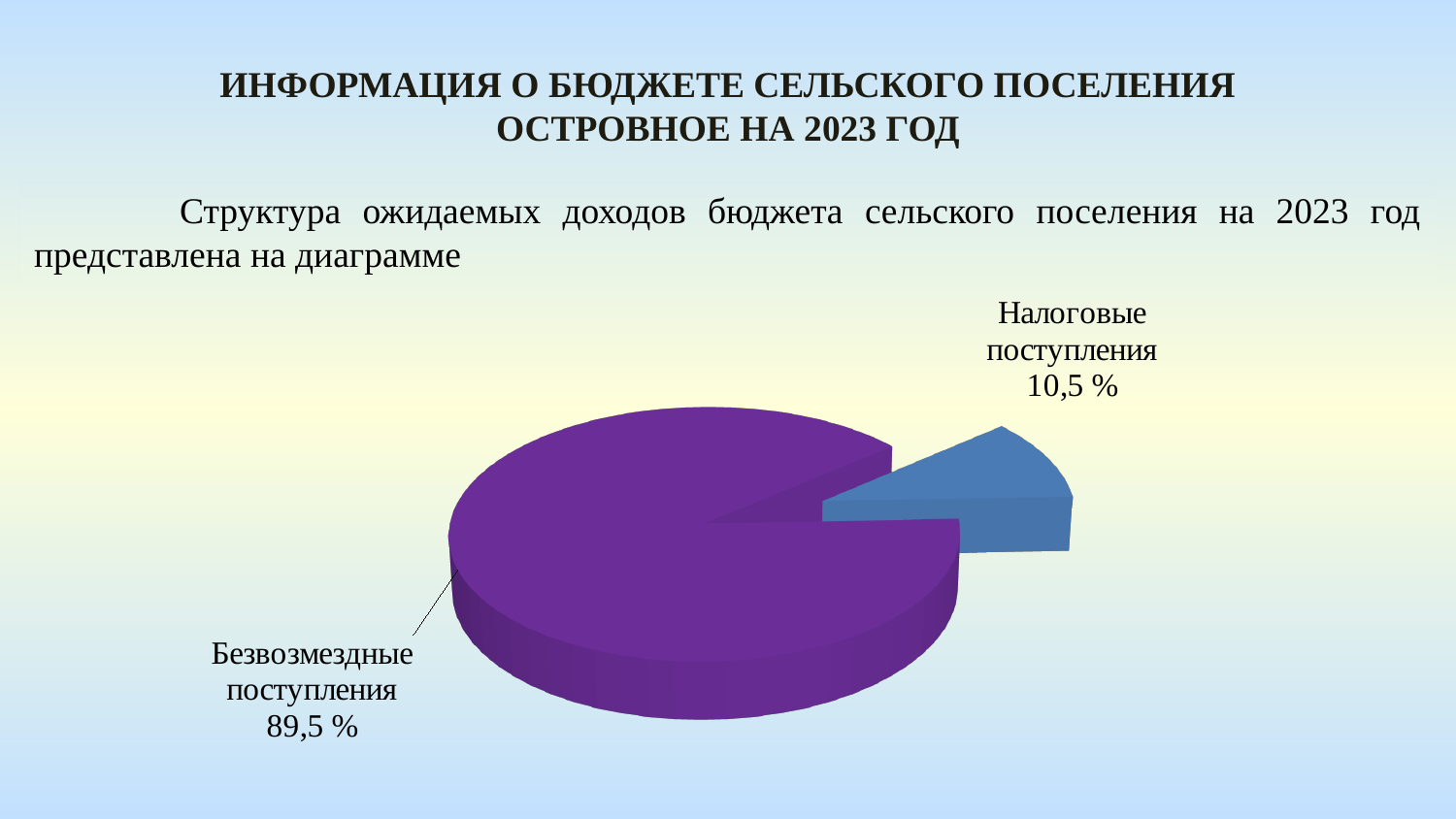
Which slice of the pie is the largest? Безвозмездные поступления What is the difference in percentage points between "Безвозмездные поступления" and "Налоговые поступления"? 79 percentage points What colour is the slice for "Безвозмездные поступления"? Purple How many slices does the pie chart have? 2 What colour is the slice for "Налоговые поступления"? Blue Is the share for "Налоговые поступления" greater or less than 50%? less What share of the pie is labelled "Налоговые поступления"? 10,5 % What kind of chart is shown on the slide? Pie chart Which slice of the pie is the smallest? Налоговые поступления What share of the pie is labelled "Безвозмездные поступления"? 89,5 % Which is larger: "Налоговые поступления" or "Безвозмездные поступления"? Безвозмездные поступления